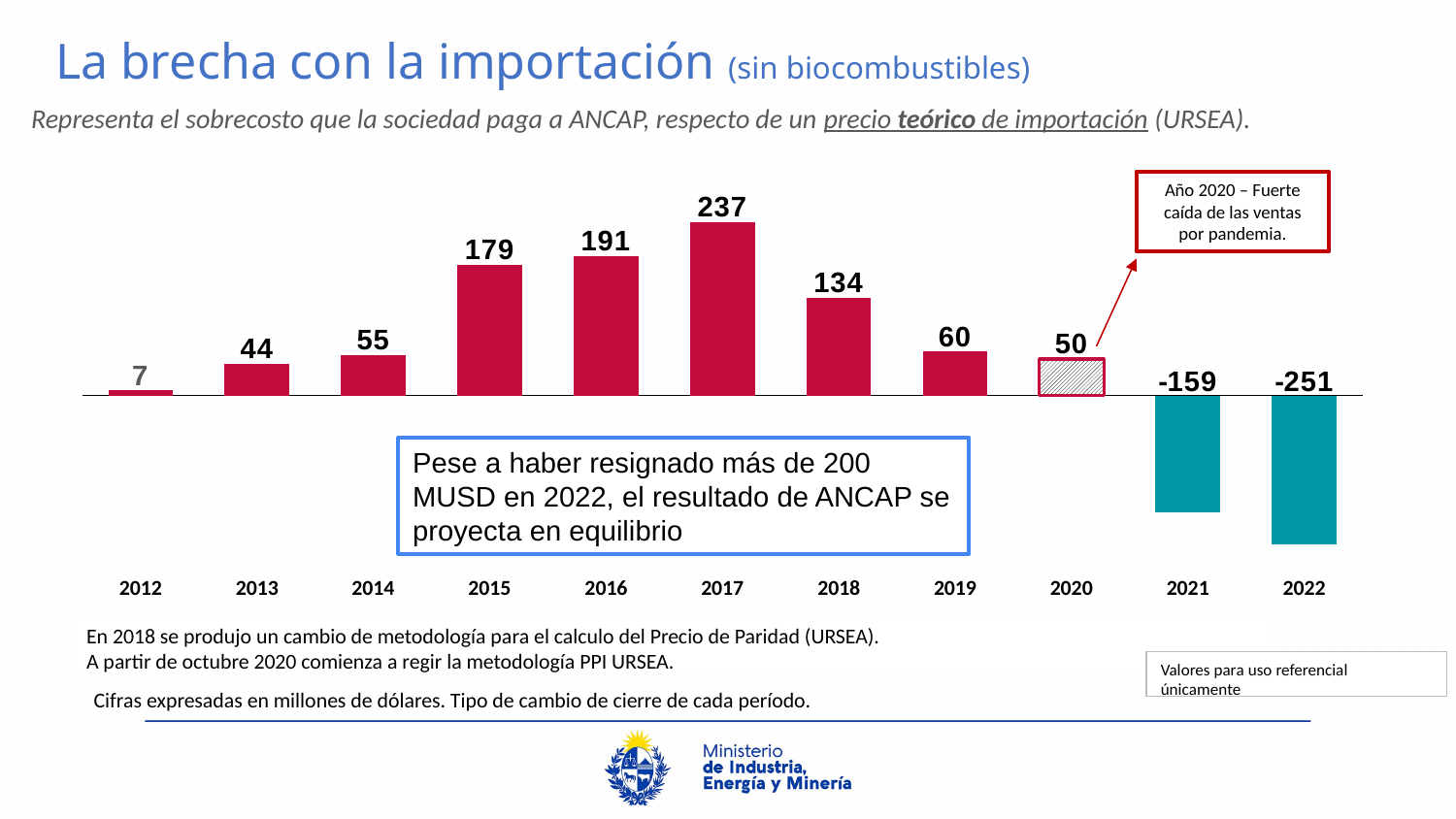
What is the difference between the values for 2016 and 2015? 12 Which year has the highest value? 2017 Which year has the lowest value? 2022 What is the value for 2022? -251 How many years are shown on the x axis? 11 What is the value for 2017? 237 Do the values rise or fall from 2012 to 2017? Rise What kind of chart is shown on the slide? Bar chart What is the difference between the values for 2017 and 2018? 103 Which is larger, the value for 2013 or the value for 2014? 2014 What is the value for 2012? 7 How many years have negative values? 2